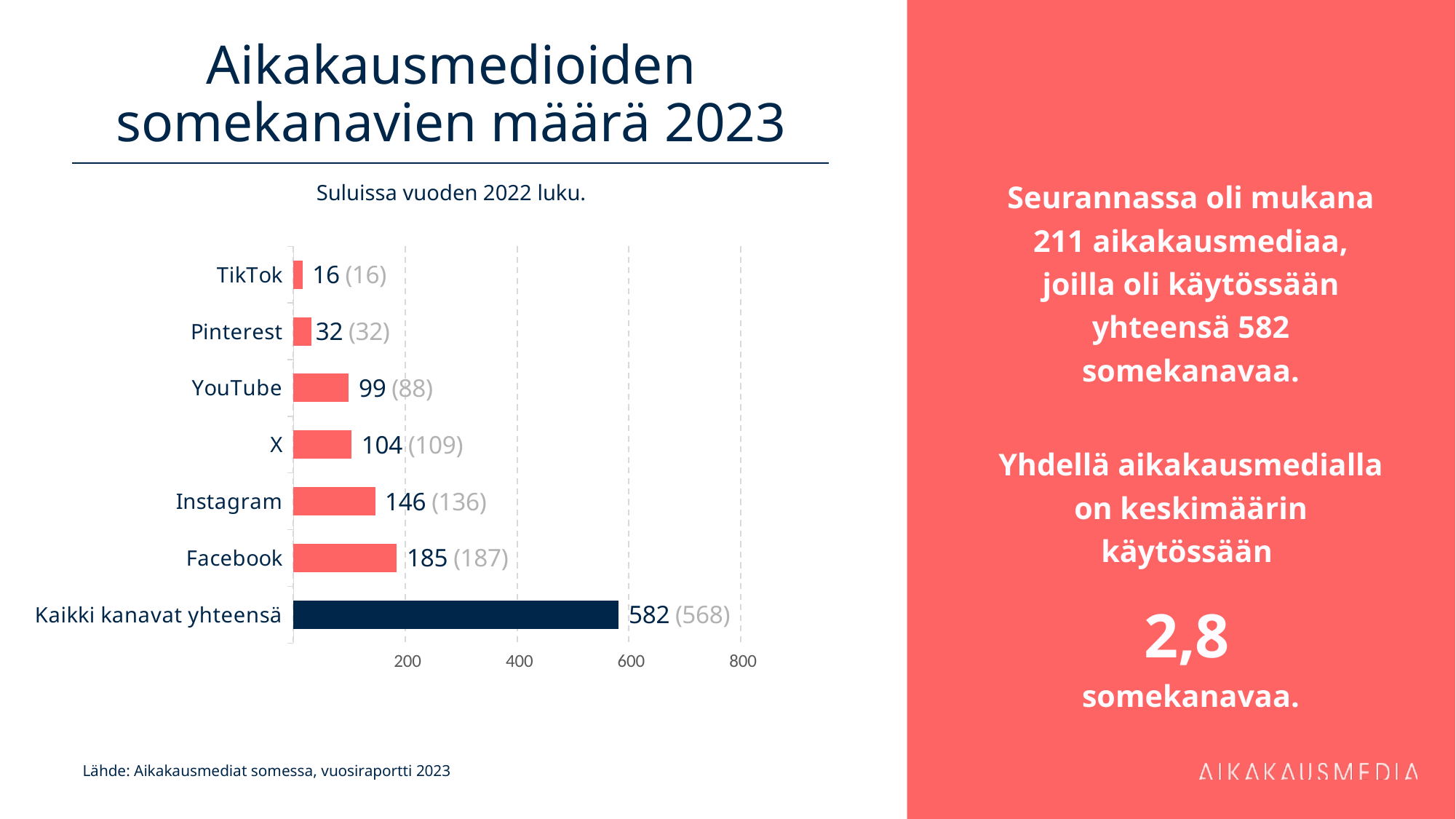
What is the difference between the 2023 values for Facebook and Instagram? 39 Which individual channel (excluding the total) has the highest 2023 value? Facebook What is the title of the chart on the slide? Aikakausmedioiden somekanavien määrä 2023 What was the 2022 value (in parentheses) for YouTube? 88 What is the 2023 value for Facebook? 185 How many categories are shown on the chart? 7 Which channel has the lowest 2023 value? TikTok What is the 2023 value for Instagram? 146 What kind of chart is shown on the slide? Bar chart Which has a larger 2023 value, X or YouTube? X By how much did the YouTube value change from 2022 to 2023? 11 What is the value for Kaikki kanavat yhteensä in 2023? 582